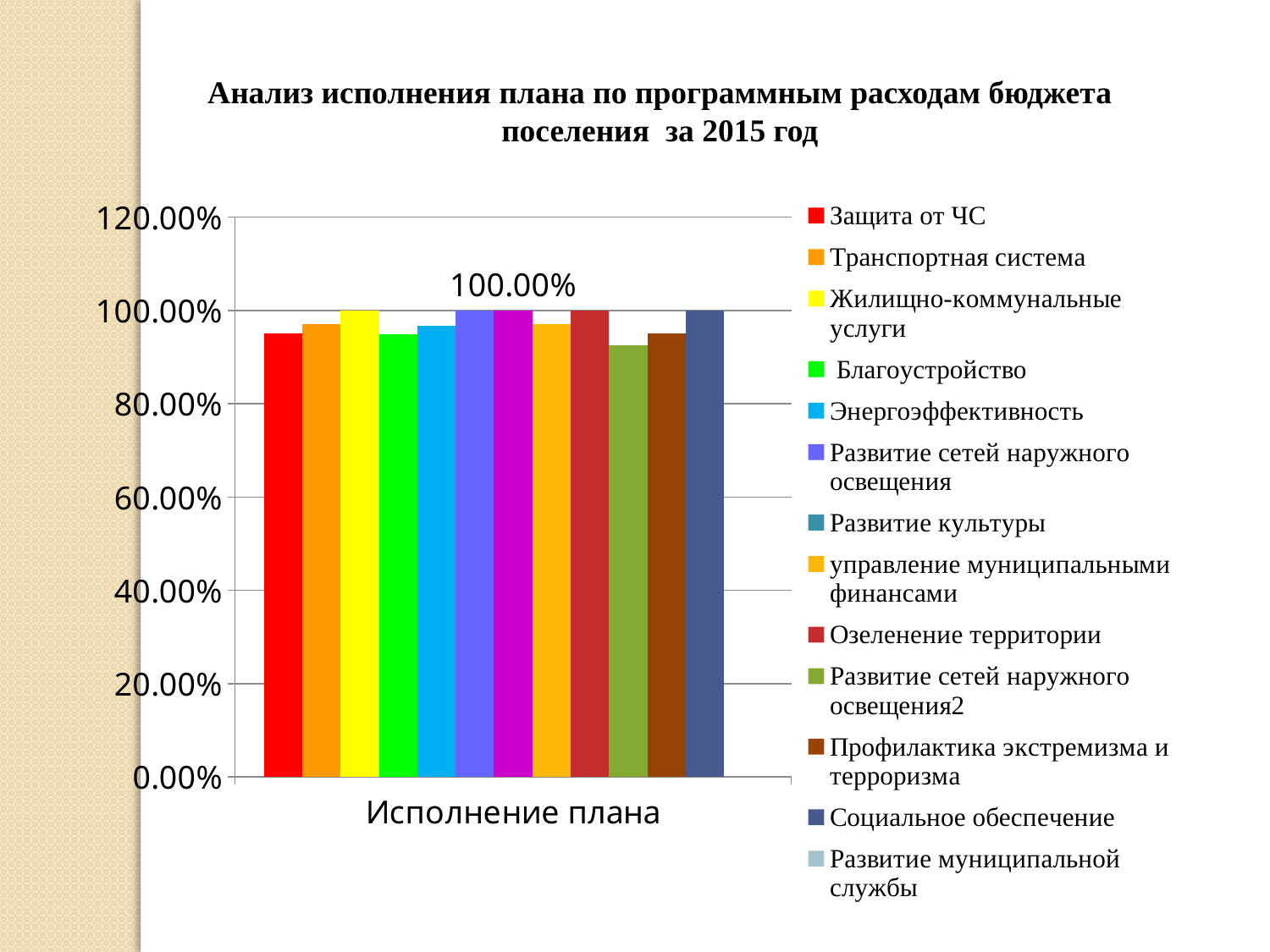
Is the value for Защита от ЧС greater or less than 100.00%? less Is the value for Развитие сетей наружного освещения2 greater or less than 80.00%? greater How many series does the legend list? 13 What value is printed as a data label on the chart? 100.00% What kind of chart is shown on the slide? bar chart Which is larger, the value for Социальное обеспечение or the value for Профилактика экстремизма и терроризма? Социальное обеспечение Which is larger, the value for Жилищно-коммунальные услуги or the value for Развитие сетей наружного освещения2? Жилищно-коммунальные услуги How many categories are shown on the x axis? 1 Is the value for Благоустройство greater or less than 100.00%? less What is the title of the slide's chart? Анализ исполнения плана по программным расходам бюджета поселения за 2015 год What is the category label shown on the x axis? Исполнение плана